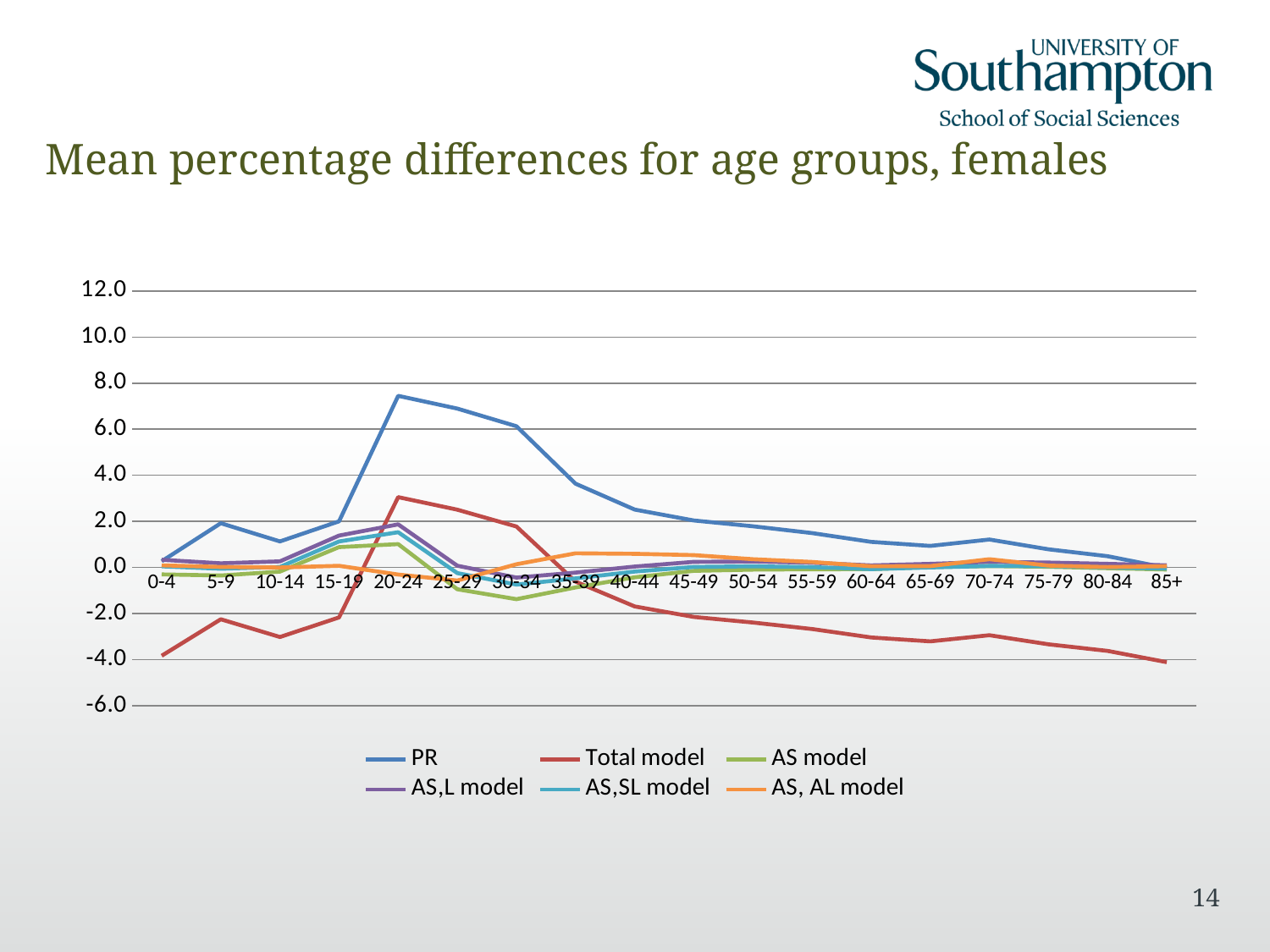
Does the PR series rise or fall from age group 20-24 to age group 85+? fall What is the title of the chart? Mean percentage differences for age groups, females Is the value for PR at age group 85+ greater or less than 2.0? less Is the value for Total model at age group 0-4 greater or less than -2.0? less How many age groups are shown along the x axis? 18 Is the value for PR at age group 20-24 greater or less than 6.0? greater How many series does the legend list? 6 Which series reaches the highest value on the chart? PR At age group 20-24, which is larger: the PR value or the Total model value? PR Which series reaches the lowest value on the chart? Total model At which age group does the PR series reach its highest value? 20-24 What kind of chart is shown on the slide? line chart